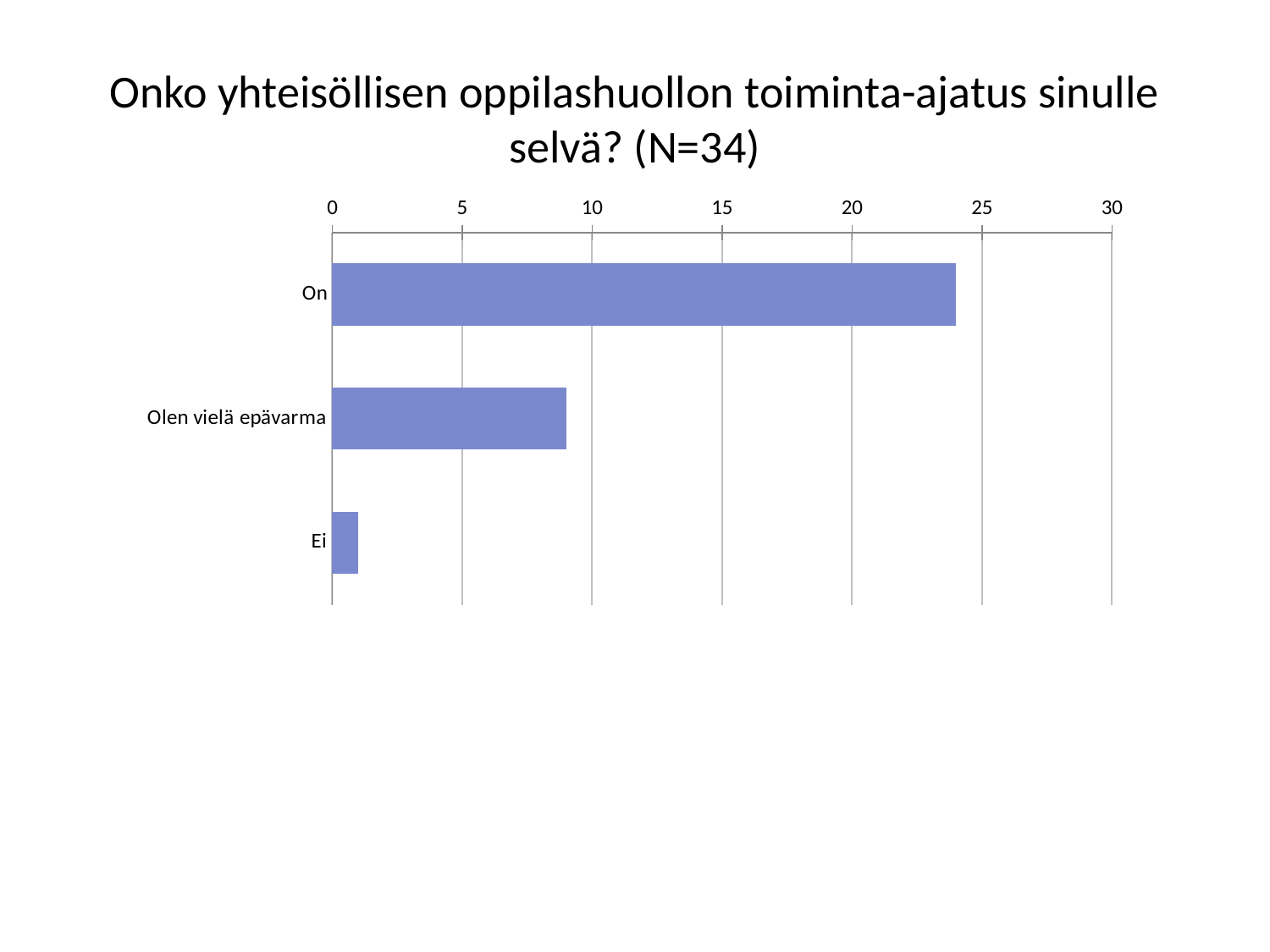
Which is larger, the value for "Olen vielä epävarma" or the value for "Ei"? Olen vielä epävarma What kind of chart is shown on the slide? bar chart Is the value for "On" greater or less than 20? greater Which category has the highest value? On Which category has the lowest value? Ei Is the value for "Olen vielä epävarma" greater or less than 10? less What is the highest value shown on the value axis? 30 Is the value for "On" greater or less than 25? less Which is larger, the value for "On" or the value for "Olen vielä epävarma"? On What is the title of the chart? Onko yhteisöllisen oppilashuollon toiminta-ajatus sinulle selvä? (N=34) How many categories are shown in the chart? 3